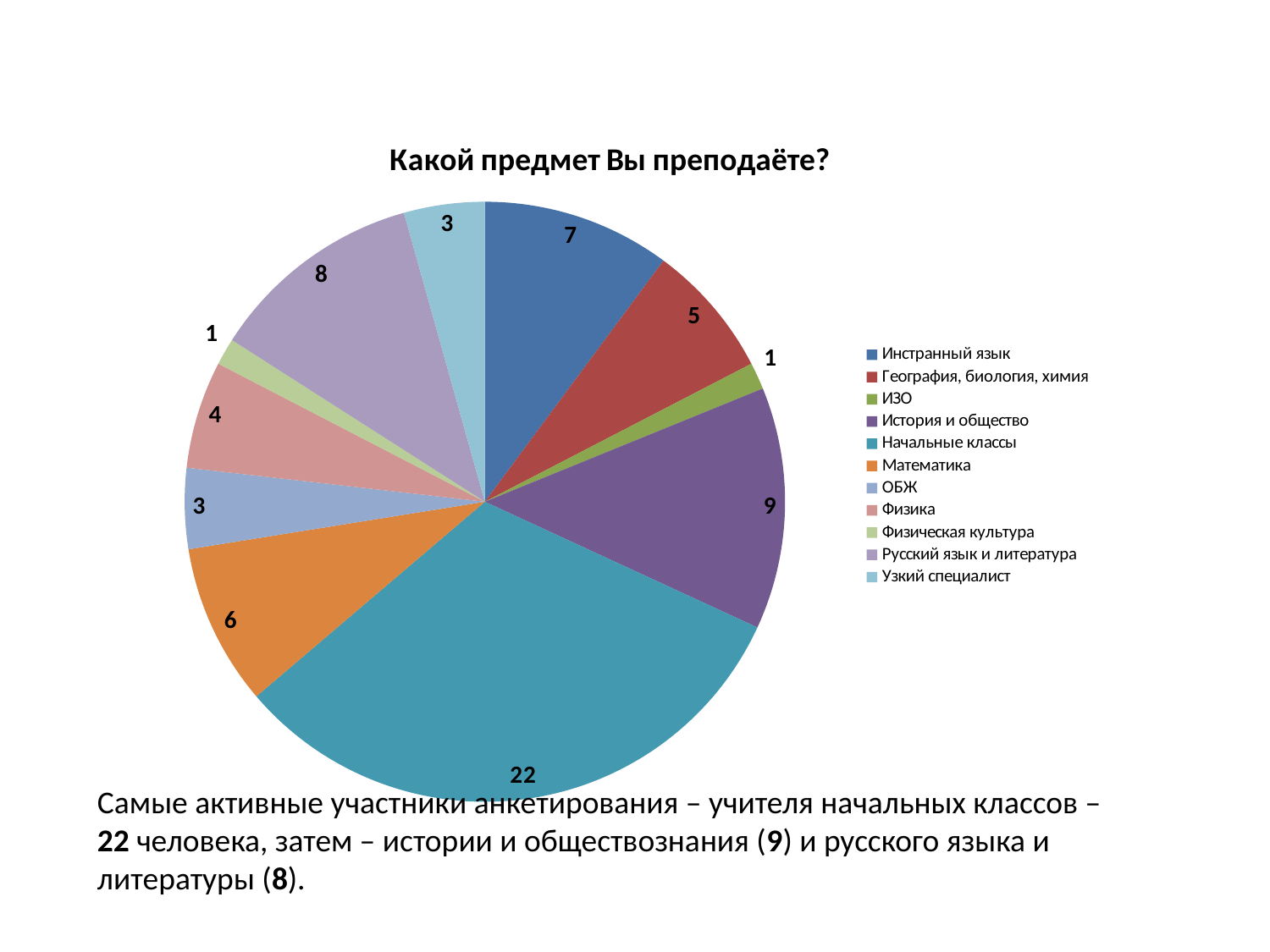
What is the value for Математика? 6 What type of chart is shown on the slide? pie chart What is the value for История и общество? 9 Which category has the largest slice of the pie? Начальные классы What is the title of the chart? Какой предмет Вы преподаёте? What is the value for Инстранный язык? 7 What is the value for Начальные классы? 22 What is the total of all the values shown on the pie chart? 69 How many categories does the legend of the pie chart list? 11 What is the difference between the values for Начальные классы and История и общество? 13 Which is larger, the value for Физика or the value for ОБЖ? Физика What is the value for Русский язык и литература? 8